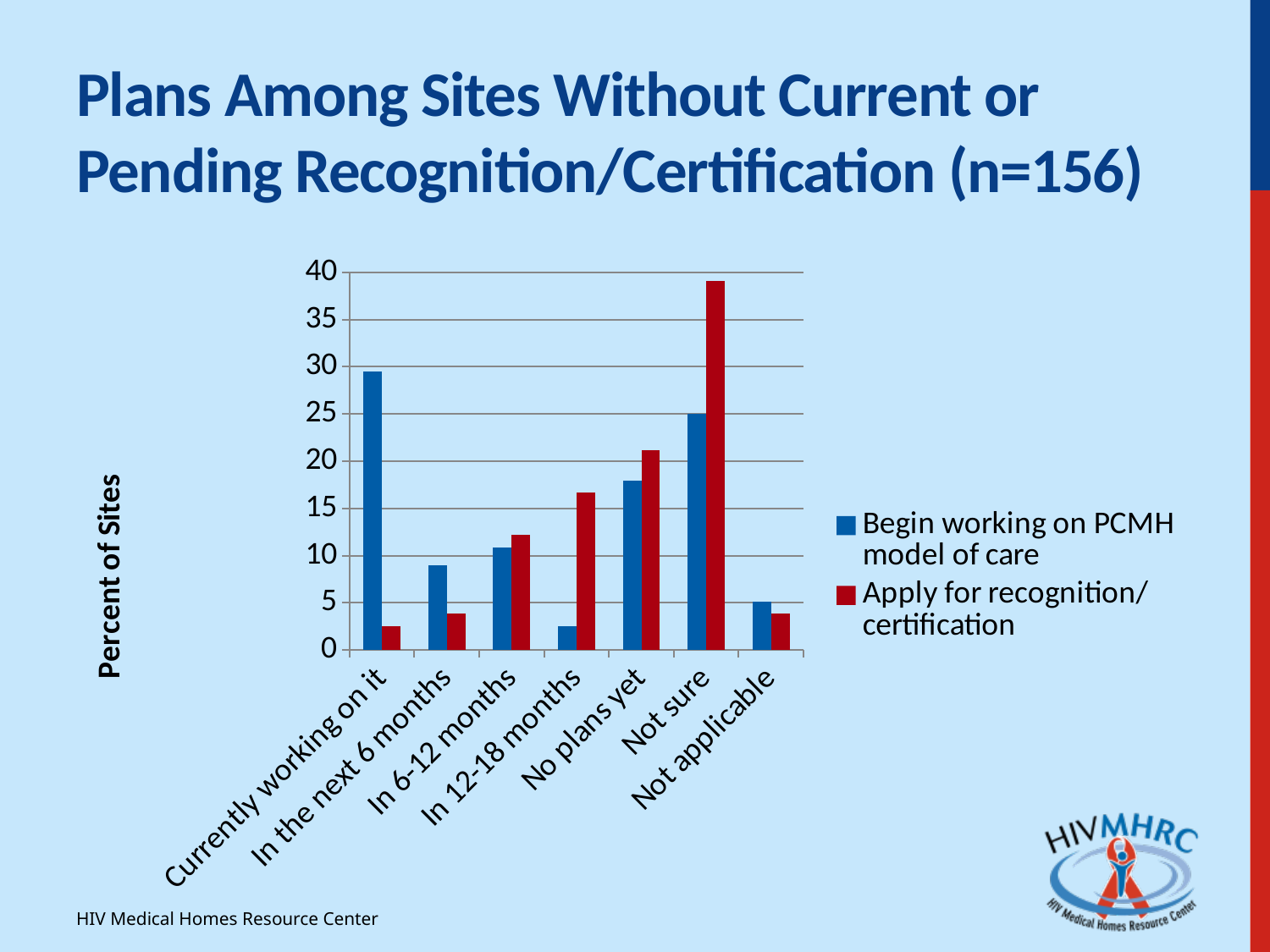
Is the 'Begin working on PCMH model of care' value for 'Currently working on it' greater or less than 25? greater Is the 'Apply for recognition/certification' value for 'Not sure' greater or less than 35? greater Which category has the lowest value for the 'Begin working on PCMH model of care' series? In 12-18 months For 'Currently working on it', which series has the larger value: 'Begin working on PCMH model of care' or 'Apply for recognition/certification'? Begin working on PCMH model of care Which category has the highest value for the 'Begin working on PCMH model of care' series? Currently working on it Which category has the highest value for the 'Apply for recognition/certification' series? Not sure Is the 'Begin working on PCMH model of care' value for 'In 12-18 months' greater or less than 5? less How many categories are shown on the x axis of the chart? 7 How many series does the chart's legend list? 2 What is the label on the vertical axis of the chart? Percent of Sites What kind of chart is shown on the slide? bar chart For 'Not sure', which series has the larger value: 'Begin working on PCMH model of care' or 'Apply for recognition/certification'? Apply for recognition/certification